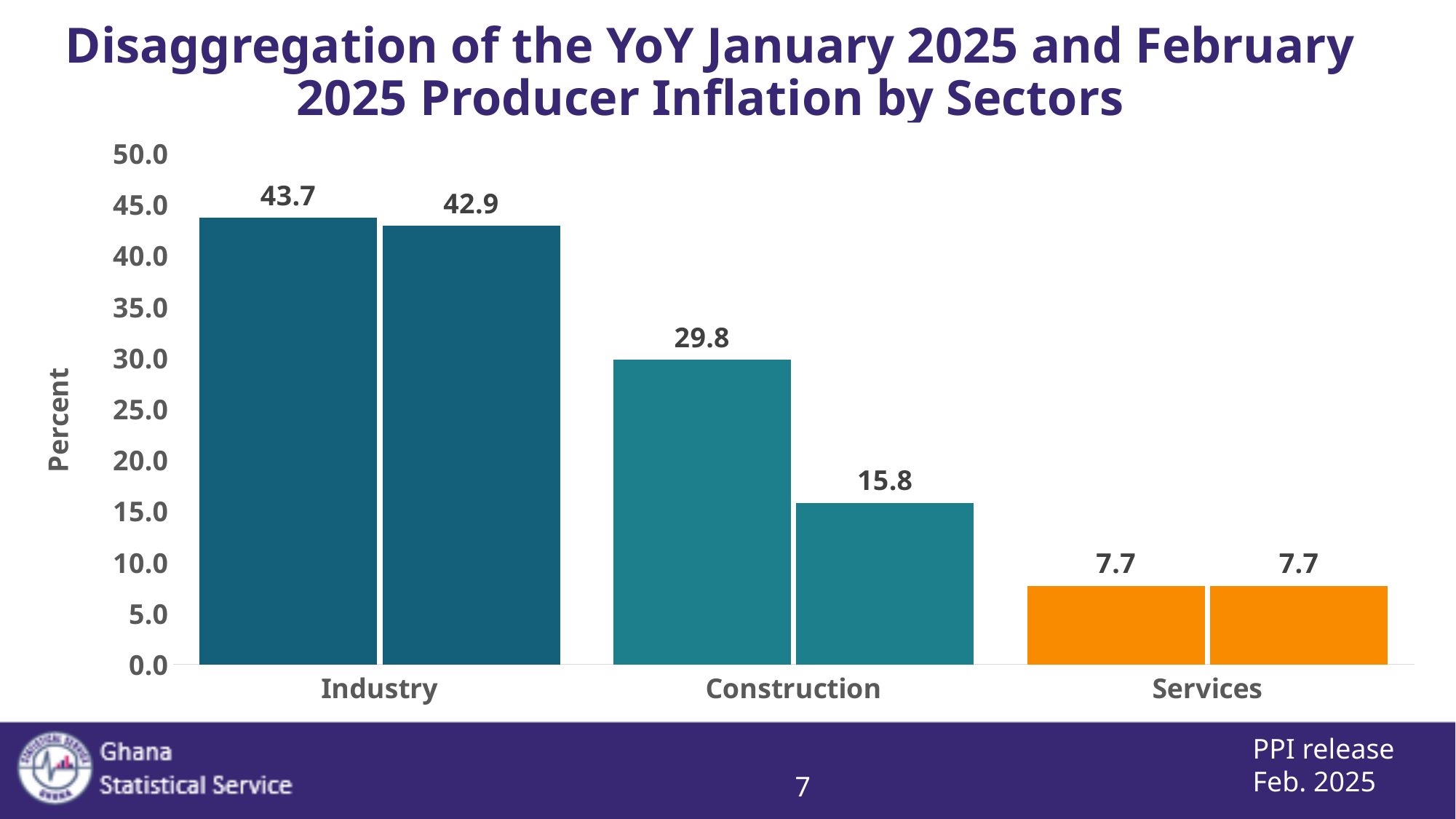
Which sector has the highest bar on the chart? Industry What is the difference between the left and right bars for Construction? 14.0 Which sector has the lowest bars on the chart? Services What value is shown for both bars in the Services sector? 7.7 What is the value of the right bar for Industry? 42.9 What is the difference between the left and right bars for Industry? 0.8 What is the value of the right bar for Construction? 15.8 What is the value of the left bar for Industry? 43.7 What type of chart is shown on the slide? Bar chart What is the value of the left bar for Construction? 29.8 Which is larger: the right bar for Construction or the right bar for Services? Construction How many sectors are shown on the x axis? 3